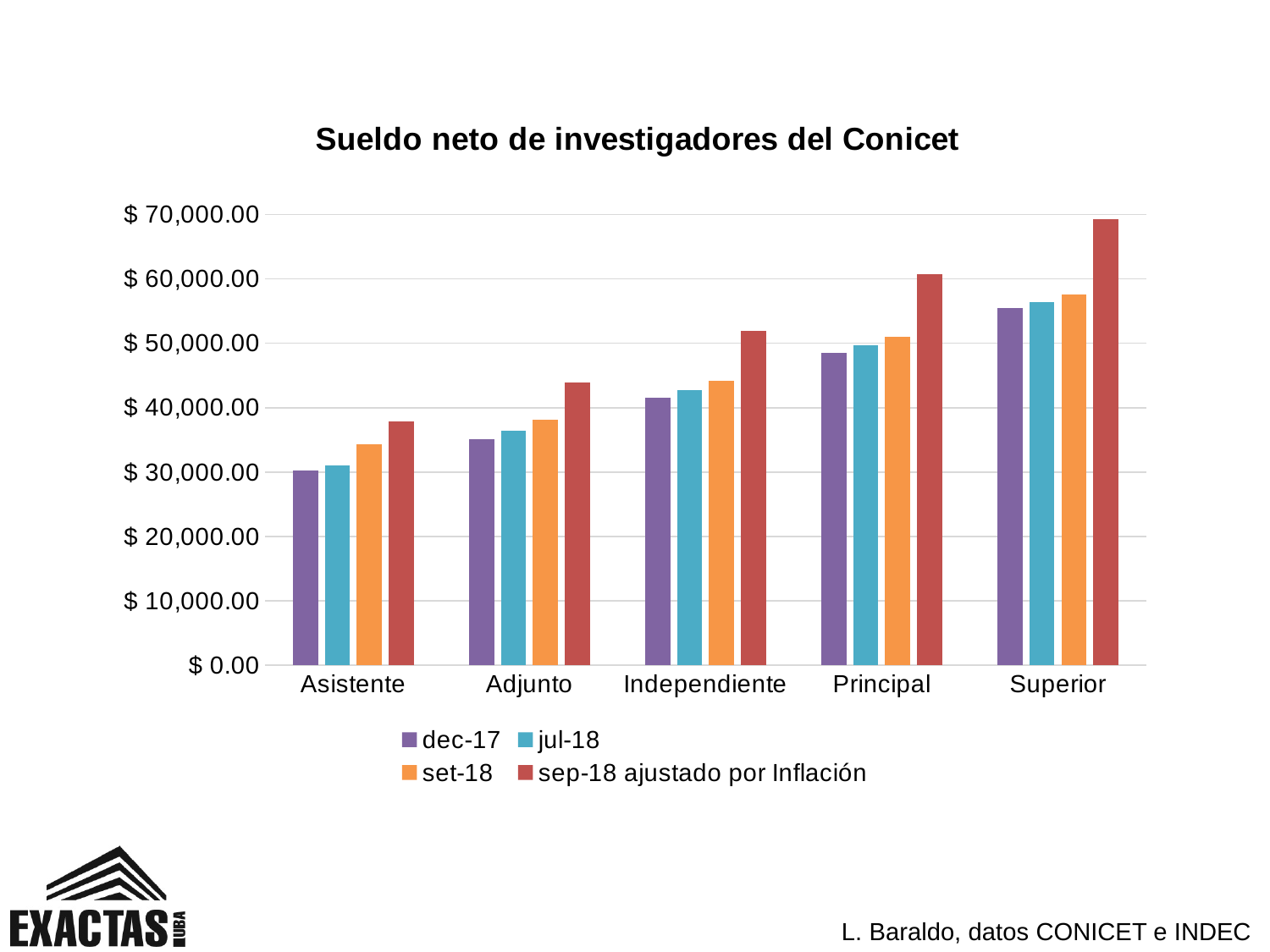
What kind of chart is shown on the slide? bar chart What is the title of the chart? Sueldo neto de investigadores del Conicet How many series does the legend list? 4 Which category has the lowest set-18 value? Asistente How many categories (researcher ranks) are shown on the x axis? 5 Which legend entry is shown in dark red? sep-18 ajustado por Inflación Is the set-18 value for Asistente greater or less than $ 40,000.00? less Is the dec-17 value for Superior greater or less than $ 50,000.00? greater Do the dec-17 values rise or fall from Asistente to Superior? rise Which category has the highest dec-17 value? Superior Which is larger: the set-18 value for Superior or the sep-18 ajustado por Inflación value for Principal? sep-18 ajustado por Inflación value for Principal Is the sep-18 ajustado por Inflación value for Superior greater or less than $ 60,000.00? greater